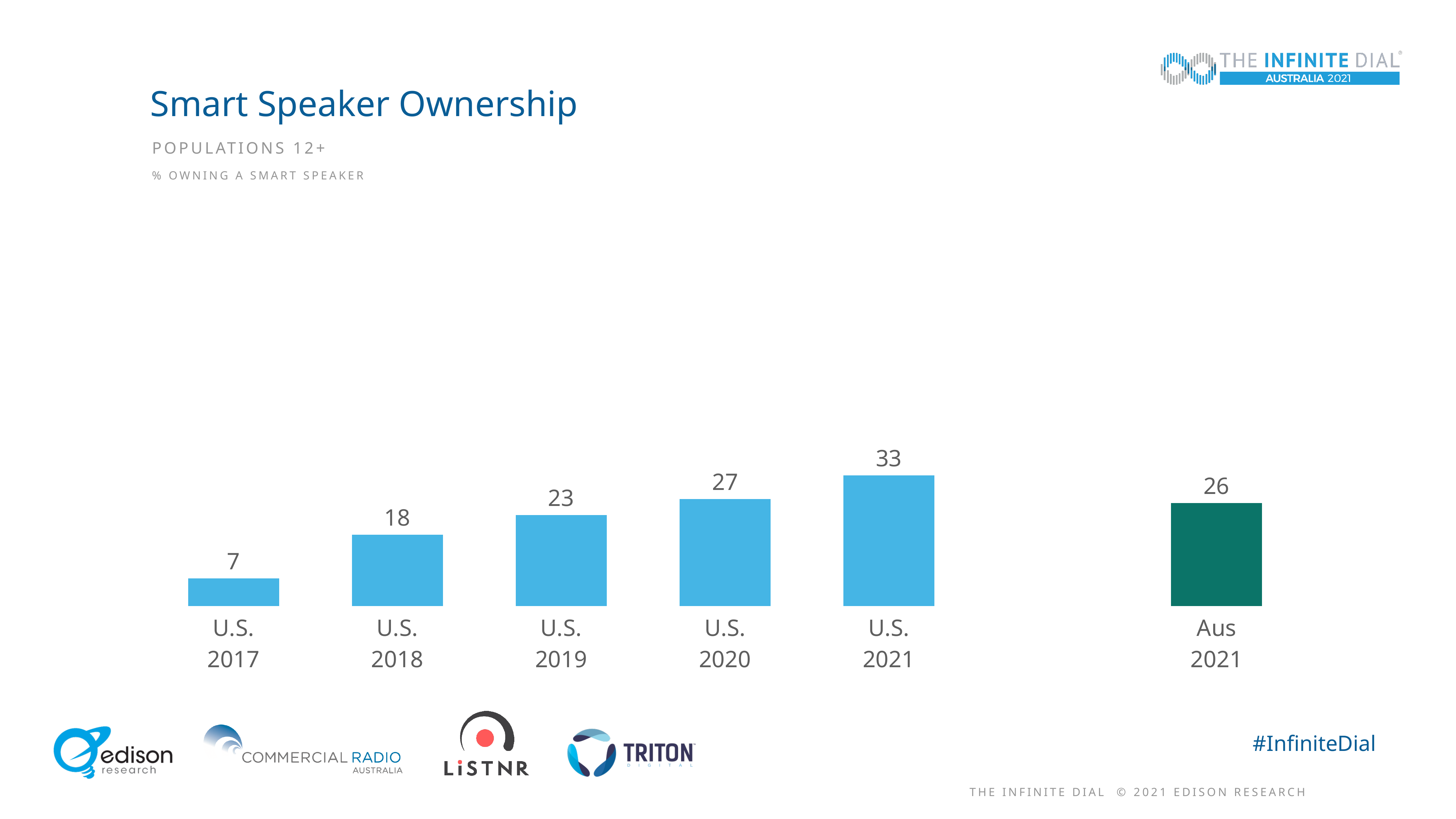
What is the value for U.S. 2019? 23 What is the title of the chart? Smart Speaker Ownership What is the value for U.S. 2017? 7 Which category has the lowest value? U.S. 2017 Which is larger, the value for U.S. 2020 or the value for Aus 2021? U.S. 2020 What is the value for Aus 2021? 26 Do the U.S. values rise or fall from 2017 to 2021? Rise Which category has the highest value? U.S. 2021 How many bars are shown in the chart? 6 What is the difference between the values for U.S. 2021 and Aus 2021? 7 What kind of chart is shown on the slide? Bar chart What is the difference between the values for U.S. 2018 and U.S. 2017? 11